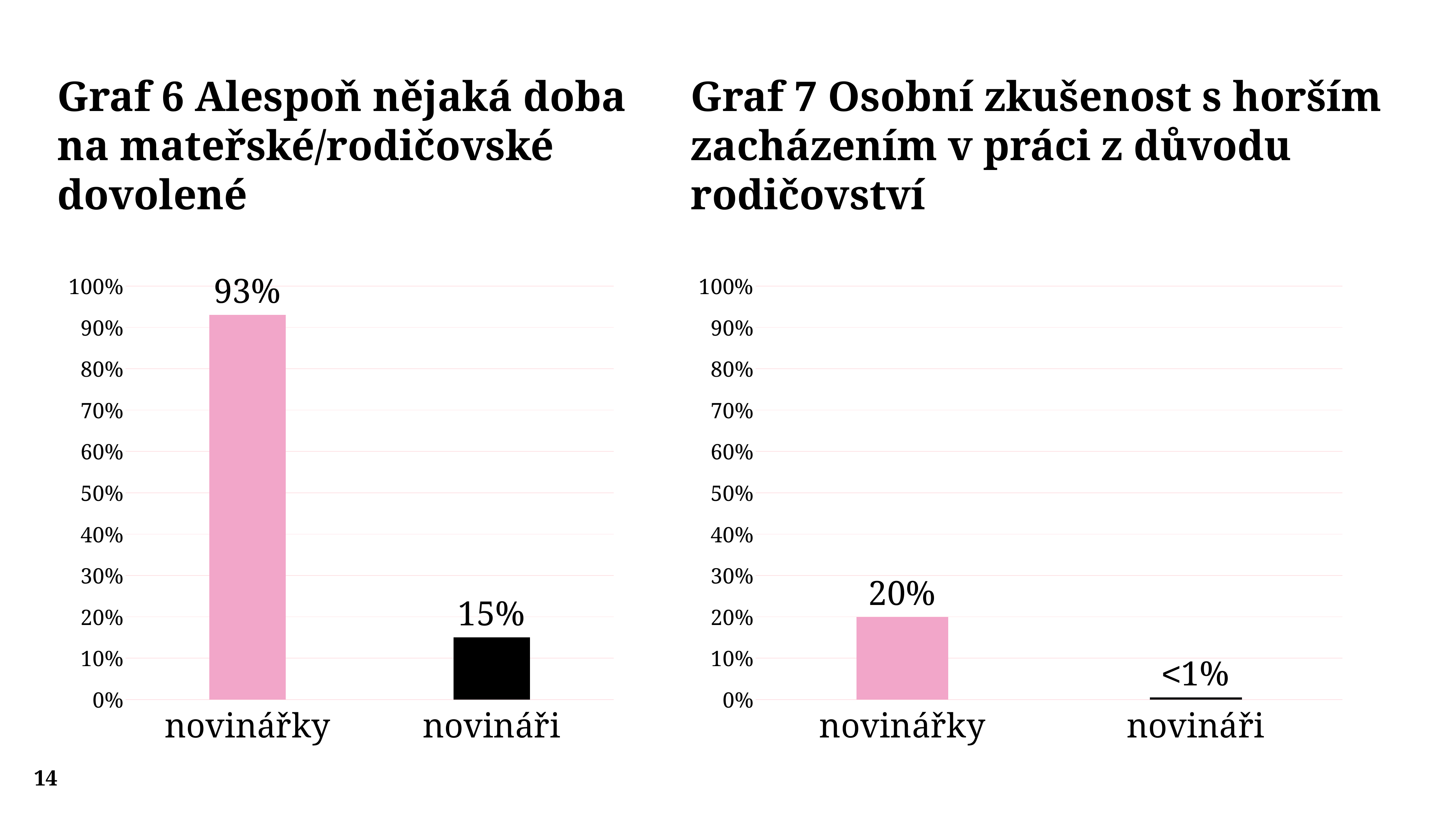
In Graf 6, what is the value for novináři? 15% In Graf 6, which category has the highest value? novinářky What kind of chart is Graf 6? bar chart In Graf 7, what is the value for novinářky? 20% In Graf 7, which category has the lowest value? novináři In Graf 6, is the value for novináři greater or less than 20%? less In Graf 7, which is larger, the value for novinářky or the value for novináři? novinářky In Graf 7, what is the value shown for novináři? <1% In Graf 6, what is the value for novinářky? 93% In Graf 6, what is the difference in percentage points between novinářky and novináři? 78 percentage points In Graf 6, what colour is the bar for novináři? black How many categories are shown in Graf 7? 2